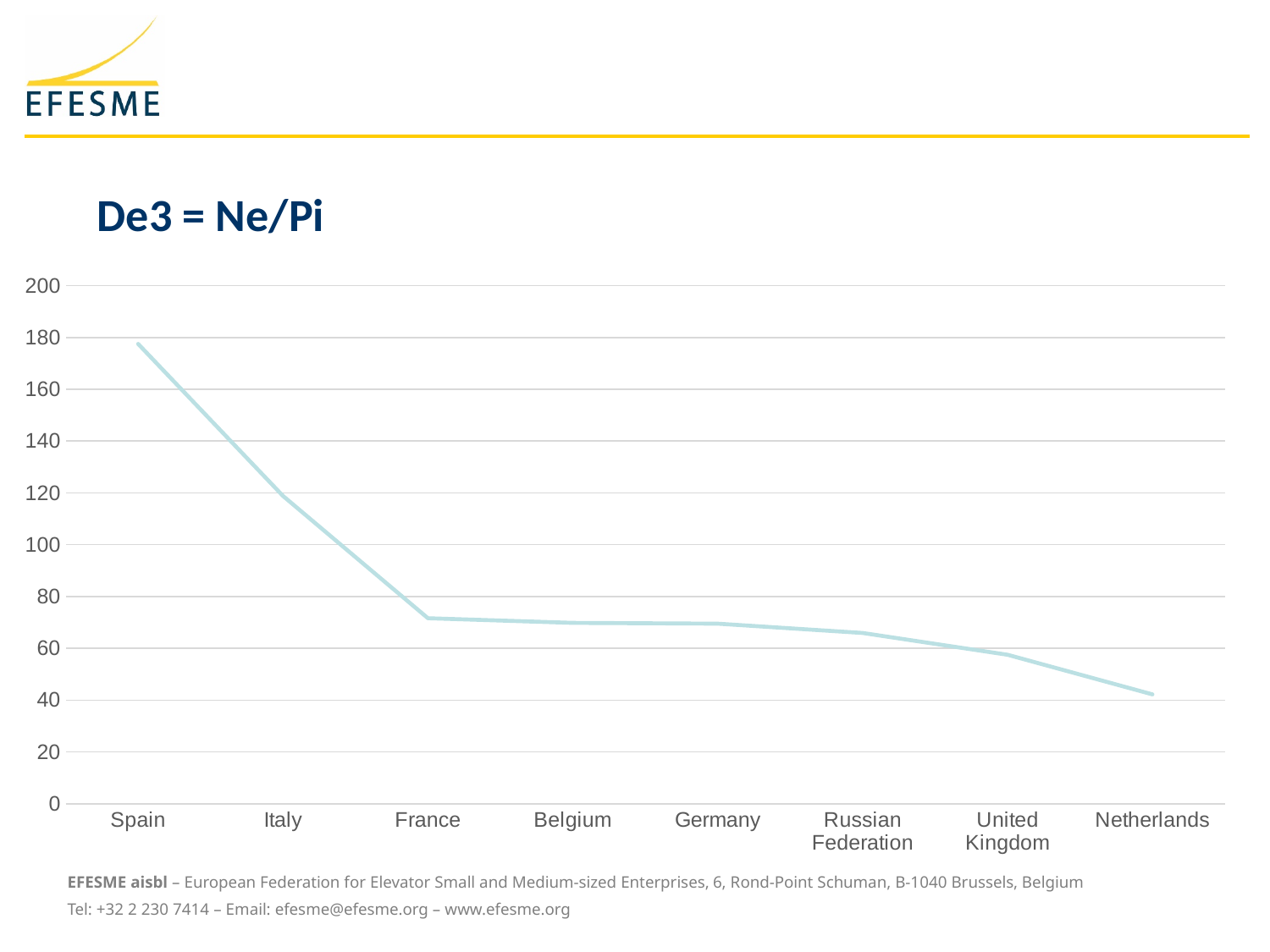
Which country has the lowest value? Netherlands Which has the larger value, United Kingdom or Netherlands? United Kingdom Which has the larger value, Spain or Italy? Spain Is the value for Italy greater or less than 100? greater Is the value for France greater or less than 80? less Do the values rise or fall moving from Spain to Netherlands along the x axis? fall Which country has the highest value? Spain Is the value for Spain greater or less than 160? greater What is the title of the chart? De3 = Ne/Pi What kind of chart is shown on the slide? line chart How many countries are plotted on the x axis? 8